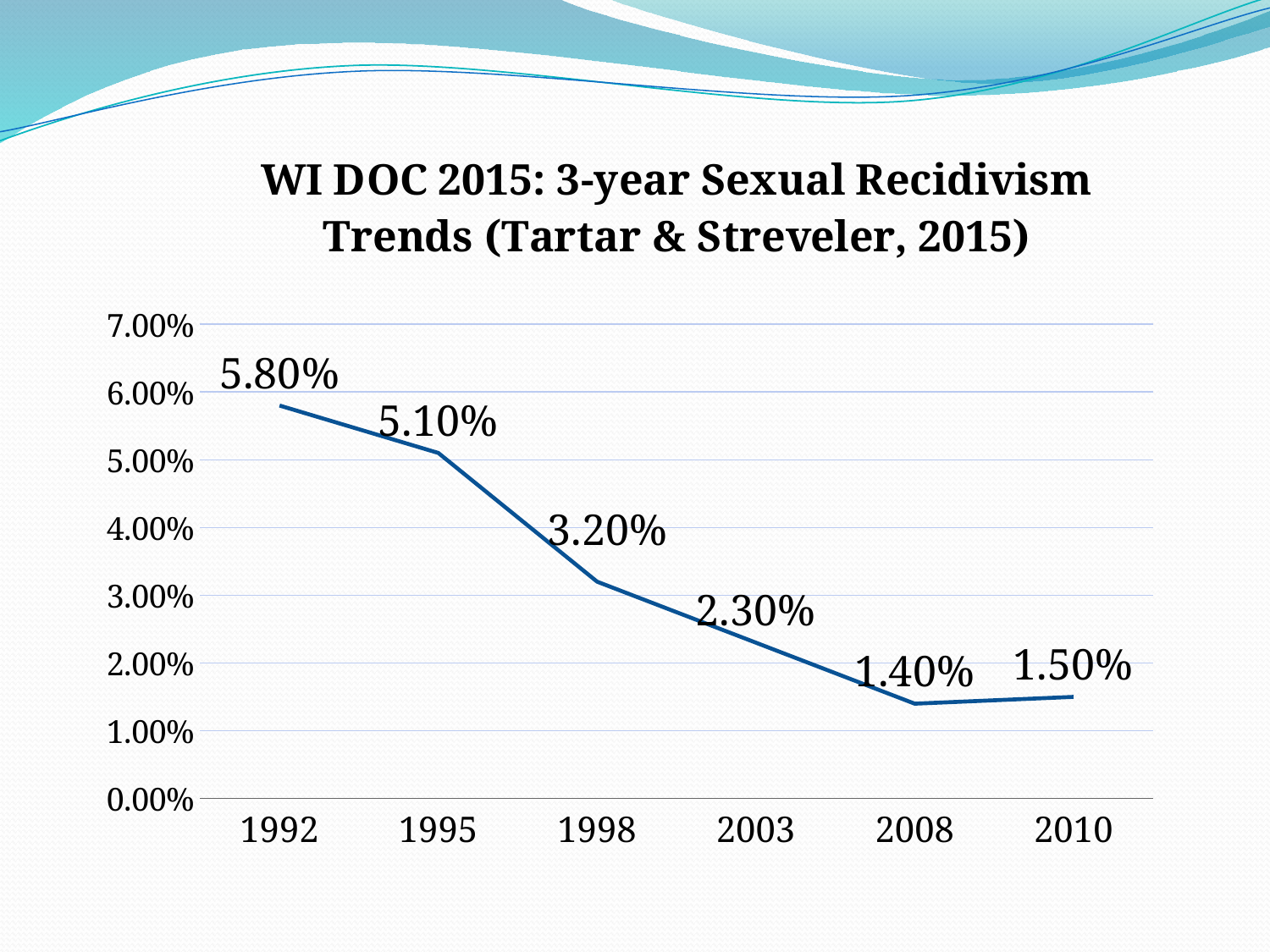
How many years are plotted on the x axis? 6 What is the value shown for 2003? 2.30% Is the value for 1995 greater or less than 4.00%? greater What is the value shown for 2010? 1.50% Which is larger, the value for 1998 or the value for 2003? 1998 Do the values generally rise or fall from 1992 to 2008? fall Which year has the highest recidivism rate? 1992 What is the difference between the 1995 and 1998 values? 1.90% What kind of chart is shown on the slide? line chart What is the 3-year sexual recidivism rate for 1992? 5.80% What is the title of the chart? WI DOC 2015: 3-year Sexual Recidivism Trends (Tartar & Streveler, 2015) Which year has the lowest recidivism rate? 2008